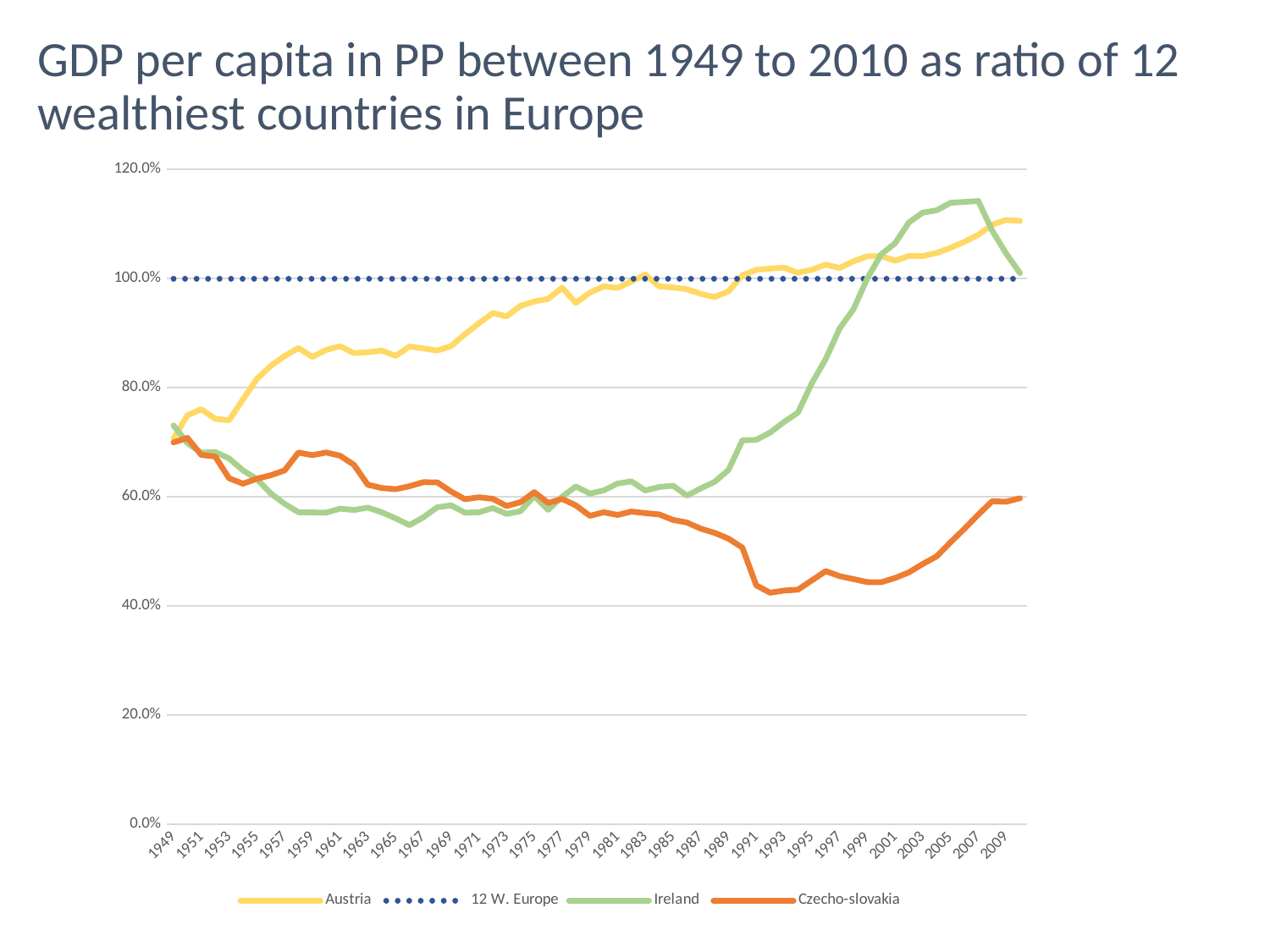
Is the value for Ireland in 2007 greater or less than 100.0%? greater Does the Czecho-slovakia series rise or fall between 1949 and 1993? fall Is the value for Czecho-slovakia in 1993 greater or less than 60.0%? less What value does the 12 W. Europe series hold across all years? 100.0% Is the value for Austria in 1949 greater or less than 80.0%? less How many series does the legend list? 4 In 2009, which is larger: the value for Austria or the value for Czecho-slovakia? Austria What kind of chart is shown on the slide? line chart Which series is drawn as a dotted line? 12 W. Europe In 1959, which is larger: the value for Ireland or the value for Czecho-slovakia? Czecho-slovakia Which series has the lowest value in 1999? Czecho-slovakia Which series has the highest value in 2005? Ireland